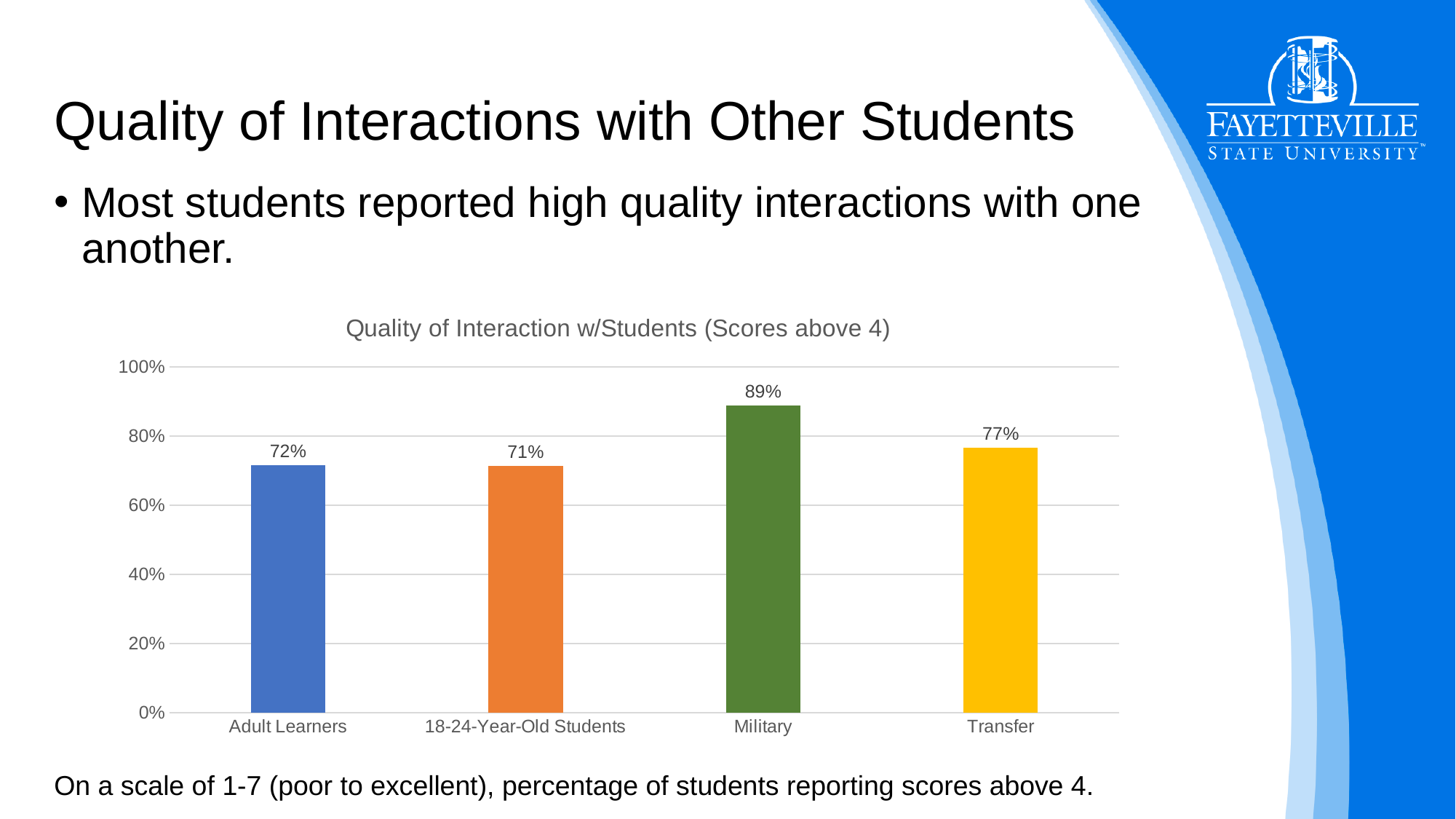
What is the difference between the values for Military and Transfer? 12% Is the value for Military greater or less than 80%? greater What is the value for Military? 89% What kind of chart is shown on the slide? Bar chart What is the value for 18-24-Year-Old Students? 71% What is the value for Adult Learners? 72% Which category has the lowest value? 18-24-Year-Old Students What is the title of the chart? Quality of Interaction w/Students (Scores above 4) Which is larger, the value for Transfer or the value for Adult Learners? Transfer Which category has the highest value? Military How many categories are shown in the chart? 4 What is the value for Transfer? 77%